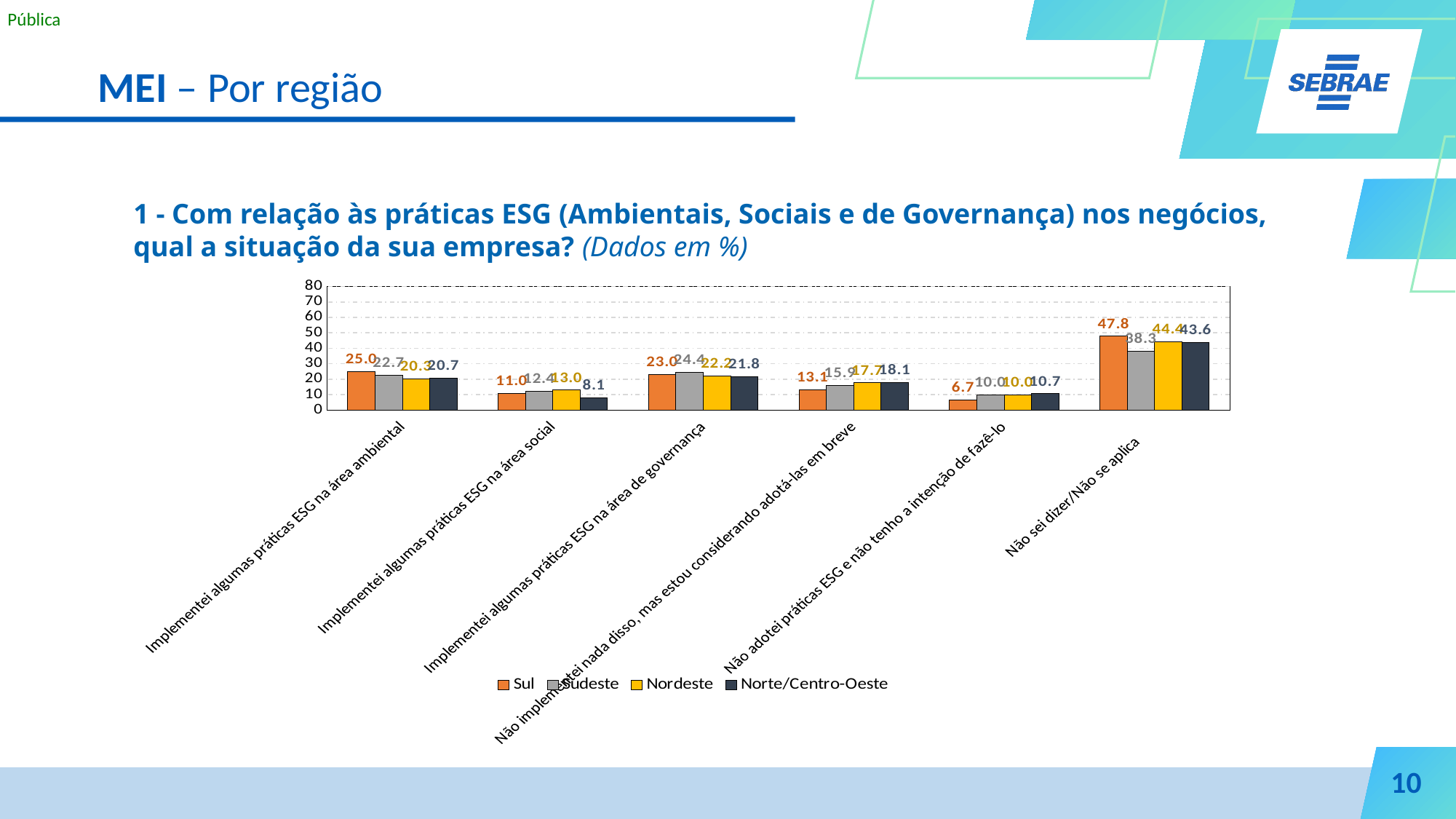
What is the value for Sudeste in the category 'Implementei algumas práticas ESG na área de governança'? 24.4 How many series does the legend list? 4 Which region has the lowest value in the category 'Não adotei práticas ESG e não tenho a intenção de fazê-lo'? Sul What is the value for Norte/Centro-Oeste in the category 'Implementei algumas práticas ESG na área social'? 8.1 How many categories are shown on the x axis? 6 What is the value for Nordeste in the category 'Não implementei nada disso, mas estou considerando adotá-las em breve'? 17.7 What is the difference between the Sul and Sudeste values in the category 'Não sei dizer/Não se aplica'? 9.5 In the category 'Implementei algumas práticas ESG na área ambiental', which is larger: the value for Sul or the value for Nordeste? Sul Which legend entry is shown in yellow? Nordeste What type of chart is shown on the slide? bar chart What is the value for Sul in the category 'Não sei dizer/Não se aplica'? 47.8 Which region has the highest value in the category 'Não sei dizer/Não se aplica'? Sul